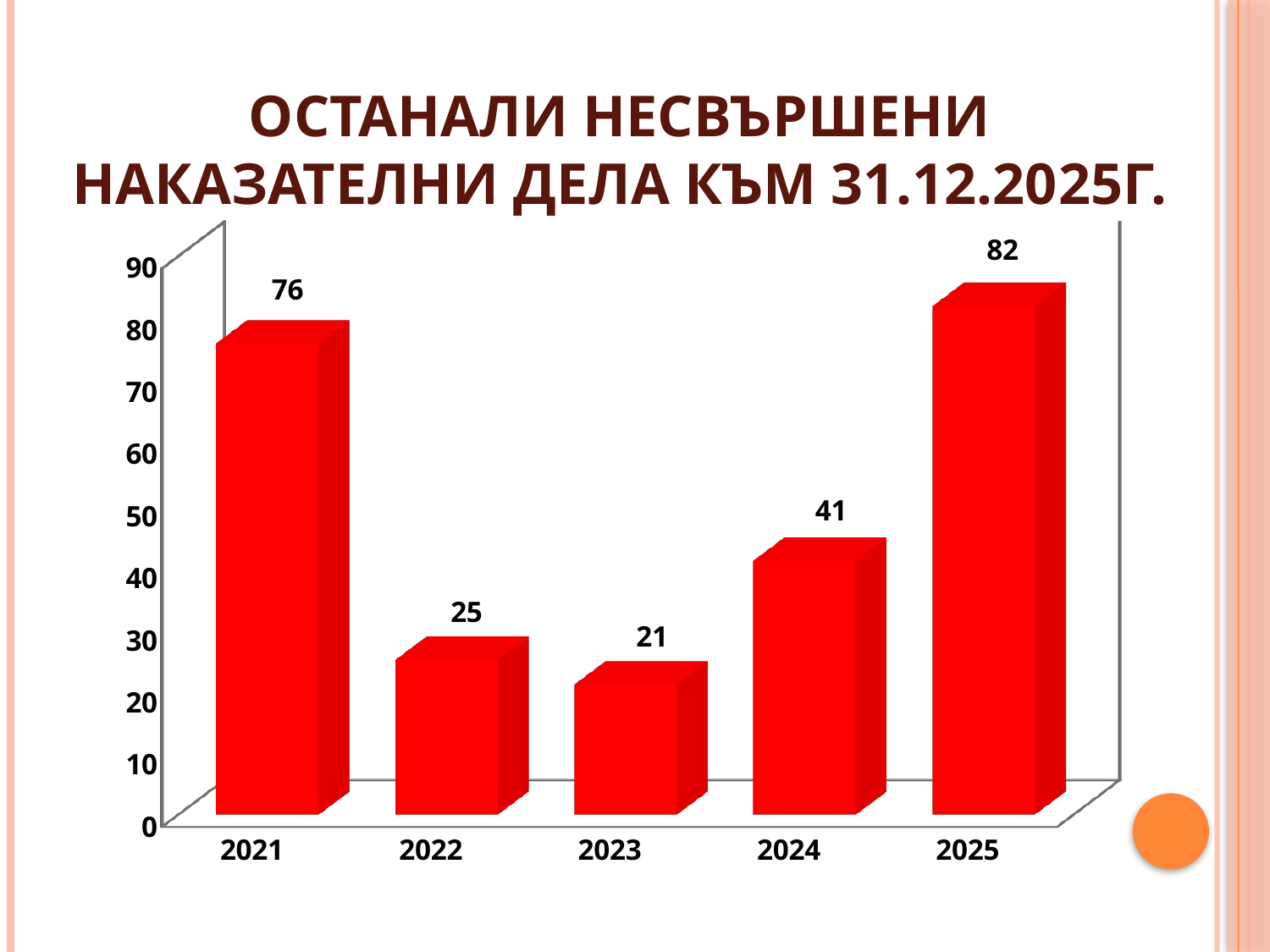
What is the value for 2021? 76 What is the title of the chart? ОСТАНАЛИ НЕСВЪРШЕНИ НАКАЗАТЕЛНИ ДЕЛА КЪМ 31.12.2025Г. Which year has the lowest value? 2023 How many years are shown on the chart? 5 Which is larger, the value for 2022 or the value for 2024? 2024 What is the difference between the values for 2025 and 2021? 6 Which year has the highest value? 2025 Is the value for 2024 greater or less than 50? less What kind of chart is shown on the slide? bar chart What is the value for 2023? 21 What is the value for 2025? 82 What is the difference between the values for 2024 and 2022? 16